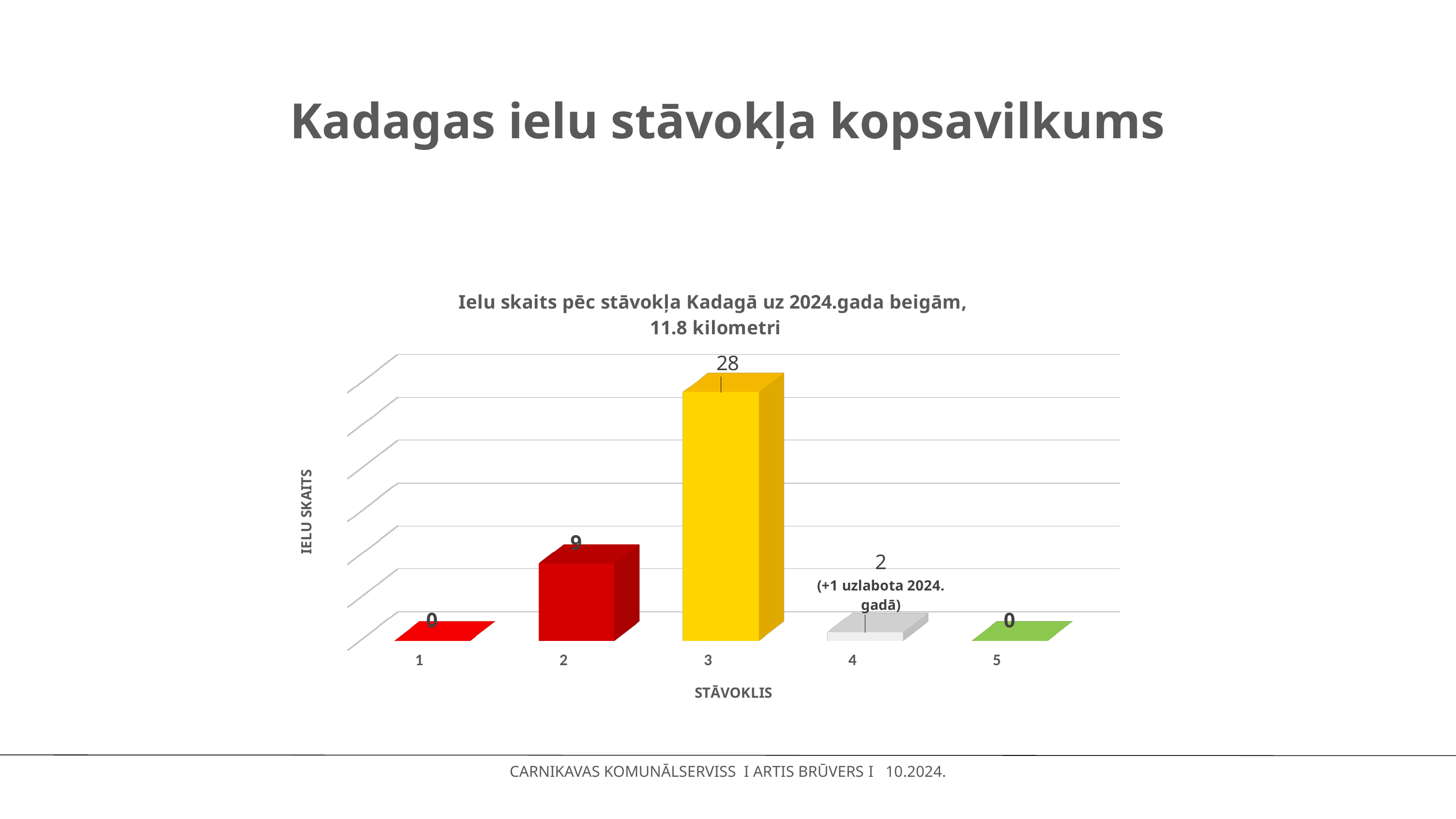
What is the difference between the values for category 3 and category 2? 19 What is the value for category 4 (stāvoklis 4)? 2 What is the value for category 1 (stāvoklis 1)? 0 How many categories are shown on the x axis? 5 What is the difference between the values for category 2 and category 4? 7 What kind of chart is shown on the slide? bar chart What is the label of the y axis? IELU SKAITS What is the value for category 2 (stāvoklis 2)? 9 What is the label of the x axis? STĀVOKLIS What is the value for category 3 (stāvoklis 3)? 28 Which is larger, the value for category 2 or the value for category 4? category 2 Which category has the highest value? 3